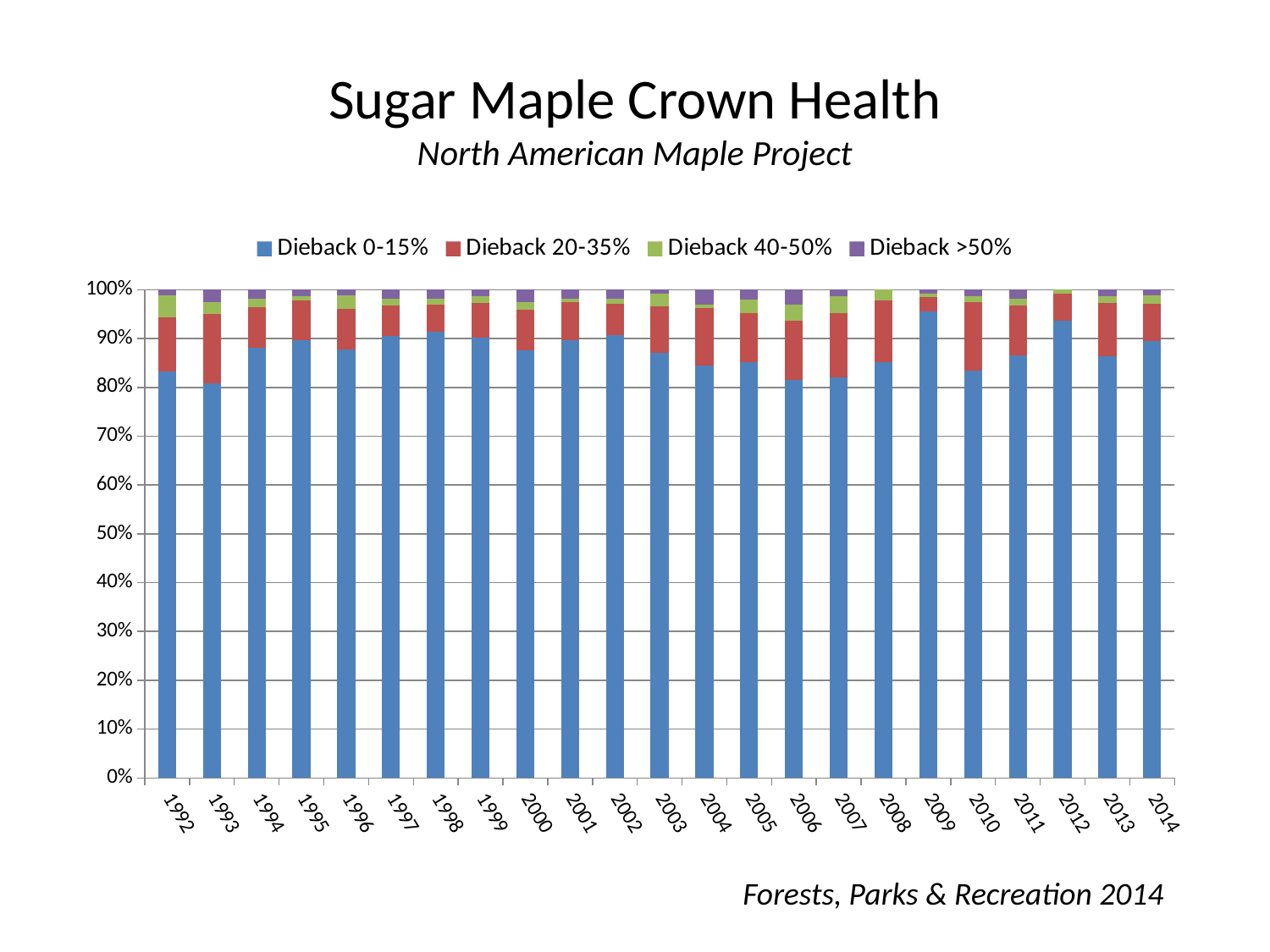
Which year has a larger Dieback 0-15% share, 2009 or 1993? 2009 Is the value for Dieback 0-15% in 2009 greater or less than 90%? greater What is the last year shown on the x axis? 2014 Which series is shown in blue? Dieback 0-15% What kind of chart is shown on the slide? stacked bar chart What does each stacked bar total? 100% What is the first year shown on the x axis? 1992 How many series does the legend list? 4 Is the value for Dieback 0-15% in 2004 greater or less than 90%? less What is the title of the chart? Sugar Maple Crown Health Is the value for Dieback 0-15% in 1993 greater or less than 90%? less How many years are shown along the x axis? 23